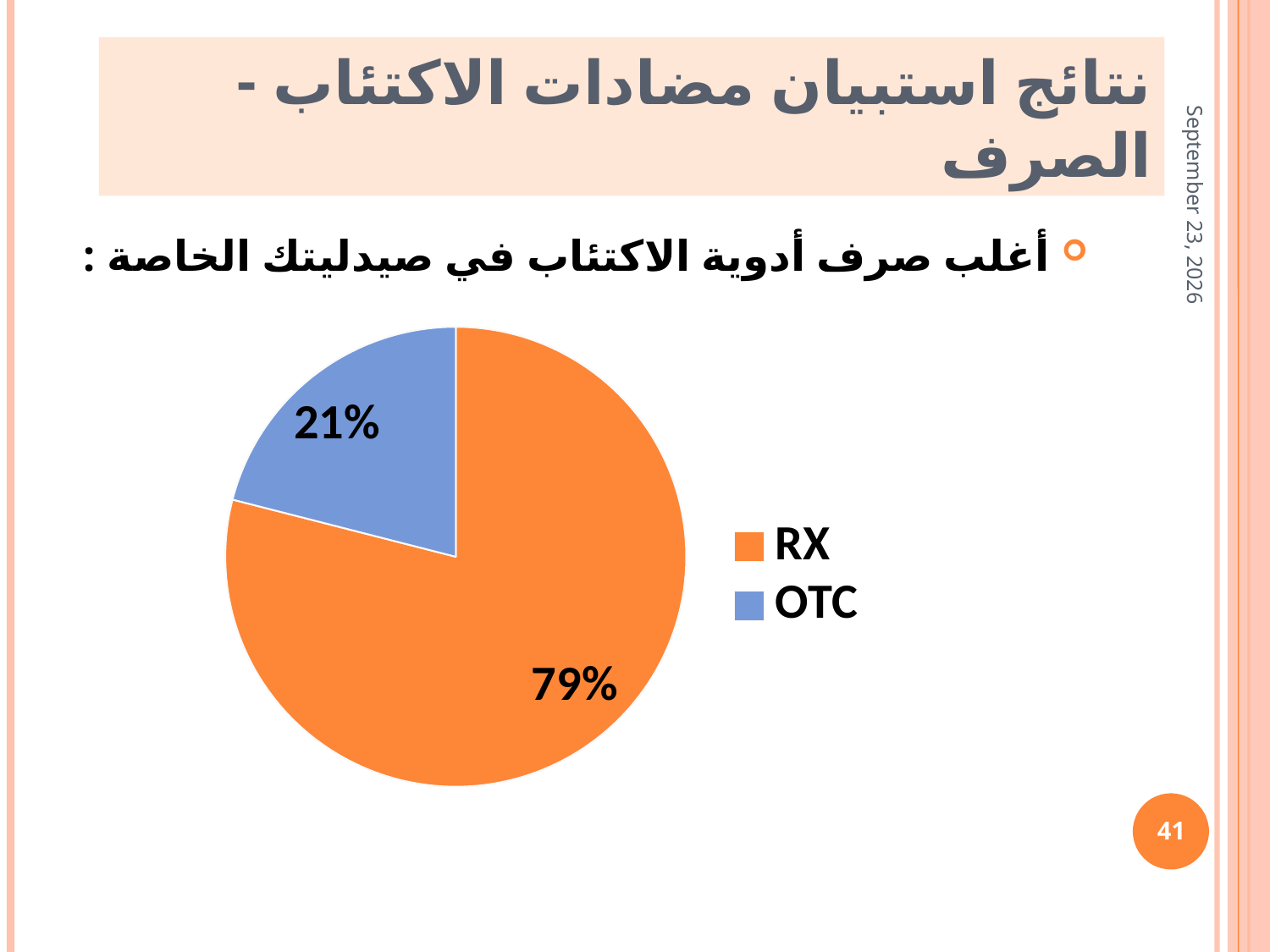
What kind of chart is shown on the slide? pie chart Which category has the smallest slice of the pie? OTC How many entries does the legend list? 2 What colour is the RX slice in the pie chart? orange What is the difference in percentage points between the RX and OTC slices? 58 How many slices does the pie chart have? 2 What share of the pie does RX account for? 79% What colour is the OTC slice in the pie chart? blue Which slice is larger, RX or OTC? RX Which category has the largest slice of the pie? RX What share of the pie does OTC account for? 21%